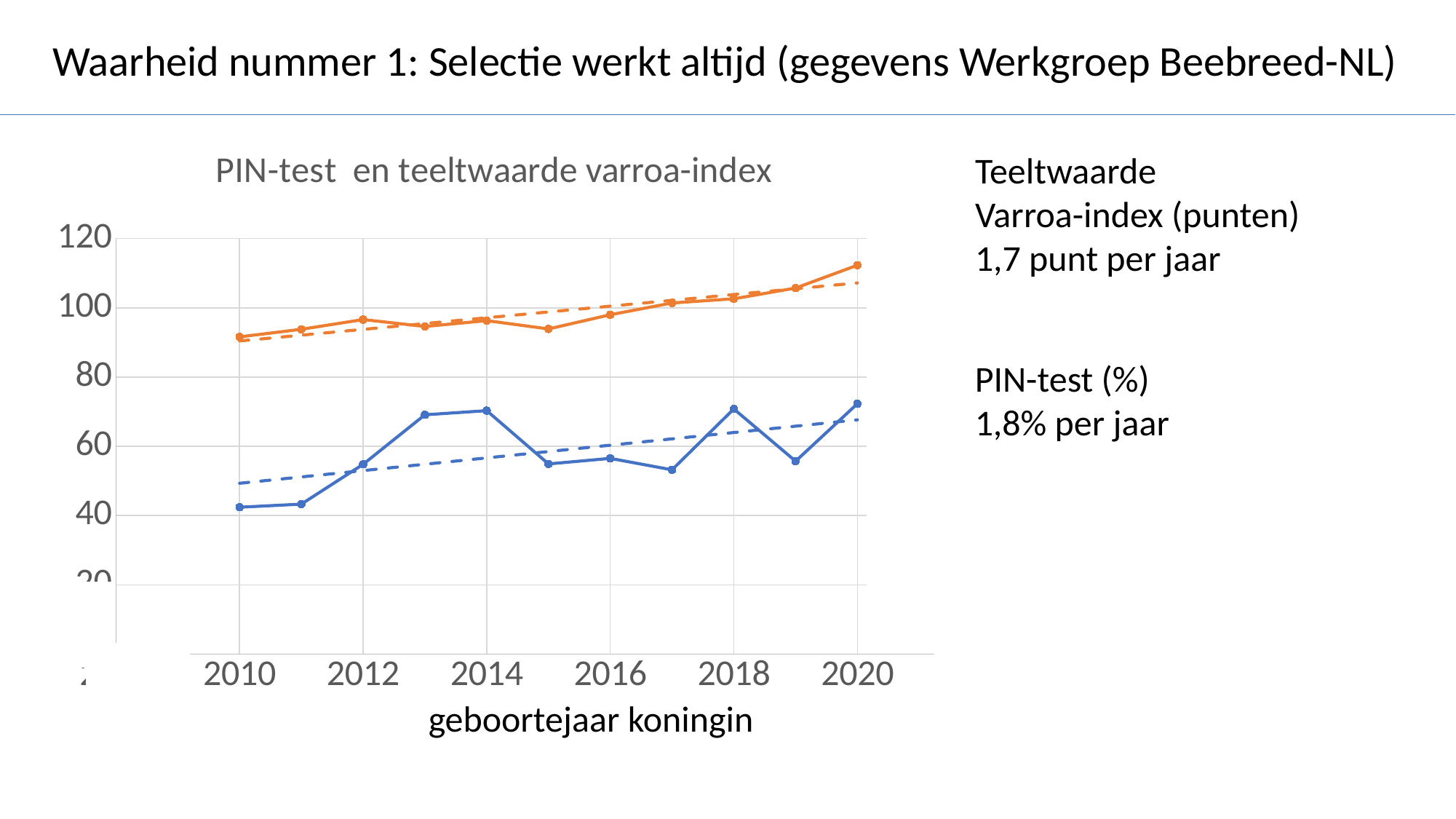
In which year is the orange Teeltwaarde Varroa-index line at its highest? 2020 How many years (data points per series) are plotted on the chart, from 2010 to 2020? 11 What is the label of the x axis of the chart? geboortejaar koningin Is the value of the blue PIN-test line for 2010 greater or less than 60? less Is the value of the orange Teeltwaarde Varroa-index line for 2010 greater or less than 100? less Is the value of the blue PIN-test line for 2013 greater or less than 60? greater Overall, does the orange Teeltwaarde Varroa-index line rise or fall from 2010 to 2020? rise What kind of chart is shown on the slide? line chart In 2015, which line has the larger value, the orange Teeltwaarde Varroa-index line or the blue PIN-test line? the orange Teeltwaarde Varroa-index line What is the title of the chart? PIN-test en teeltwaarde varroa-index